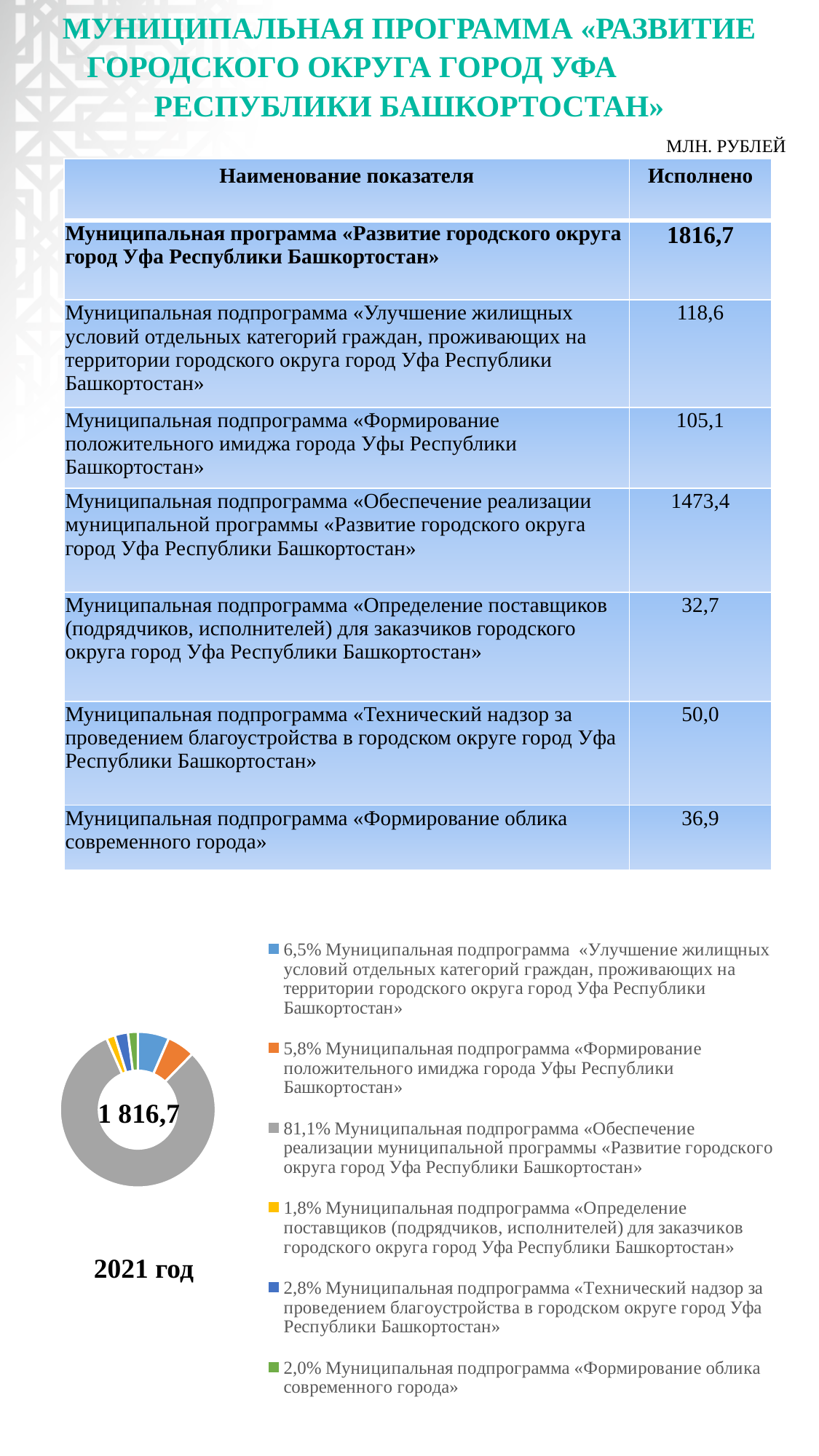
What share of the donut chart does the subprogram «Формирование положительного имиджа города Уфы Республики Башкортостан» have? 5,8% In the donut chart, which has the larger share: «Технический надзор за проведением благоустройства...» or «Формирование облика современного города»? «Технический надзор за проведением благоустройства...» (2,8%) What share of the donut chart does the subprogram «Обеспечение реализации муниципальной программы «Развитие городского округа город Уфа Республики Башкортостан» have? 81,1% What kind of chart is shown at the bottom of the slide? Pie (donut) chart Which subprogram has the smallest slice in the donut chart? Муниципальная подпрограмма «Определение поставщиков (подрядчиков, исполнителей) для заказчиков городского округа город Уфа Республики Башкортостан» How many entries does the legend of the donut chart list? 6 What total value is printed in the centre of the donut chart? 1 816,7 What is the difference in percentage points between the shares of «Улучшение жилищных условий...» (6,5%) and «Формирование положительного имиджа...» (5,8%) in the donut chart? 0,7 percentage points What share of the donut chart does the subprogram «Улучшение жилищных условий отдельных категорий граждан...» have? 6,5% What year is labelled below the donut chart? 2021 год Which subprogram has the largest slice in the donut chart? Муниципальная подпрограмма «Обеспечение реализации муниципальной программы «Развитие городского округа город Уфа Республики Башкортостан»